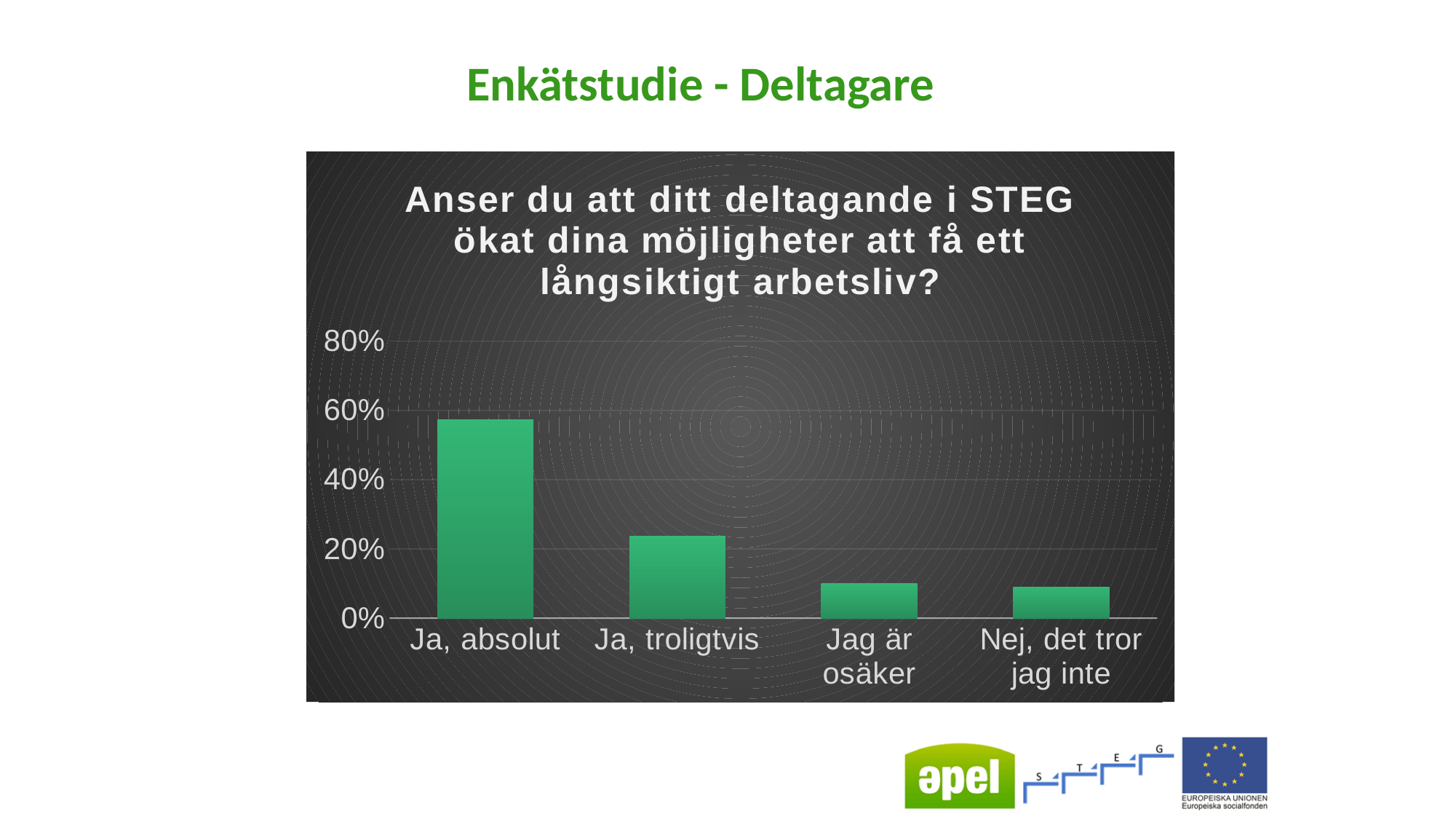
Which category has the highest value in the chart? Ja, absolut What type of chart is shown on the slide? Bar chart Is the value for "Ja, absolut" greater or less than 40%? greater Is the value for "Ja, absolut" greater or less than 60%? less Which is larger, the value for "Ja, troligtvis" or the value for "Jag är osäker"? Ja, troligtvis Which is larger, the value for "Ja, absolut" or the value for "Ja, troligtvis"? Ja, absolut How many categories are shown on the x axis of the chart? 4 Is the value for "Nej, det tror jag inte" greater or less than 20%? less What is the title of the chart? Anser du att ditt deltagande i STEG ökat dina möjligheter att få ett långsiktigt arbetsliv? What is the highest value shown on the y axis of the chart? 80%